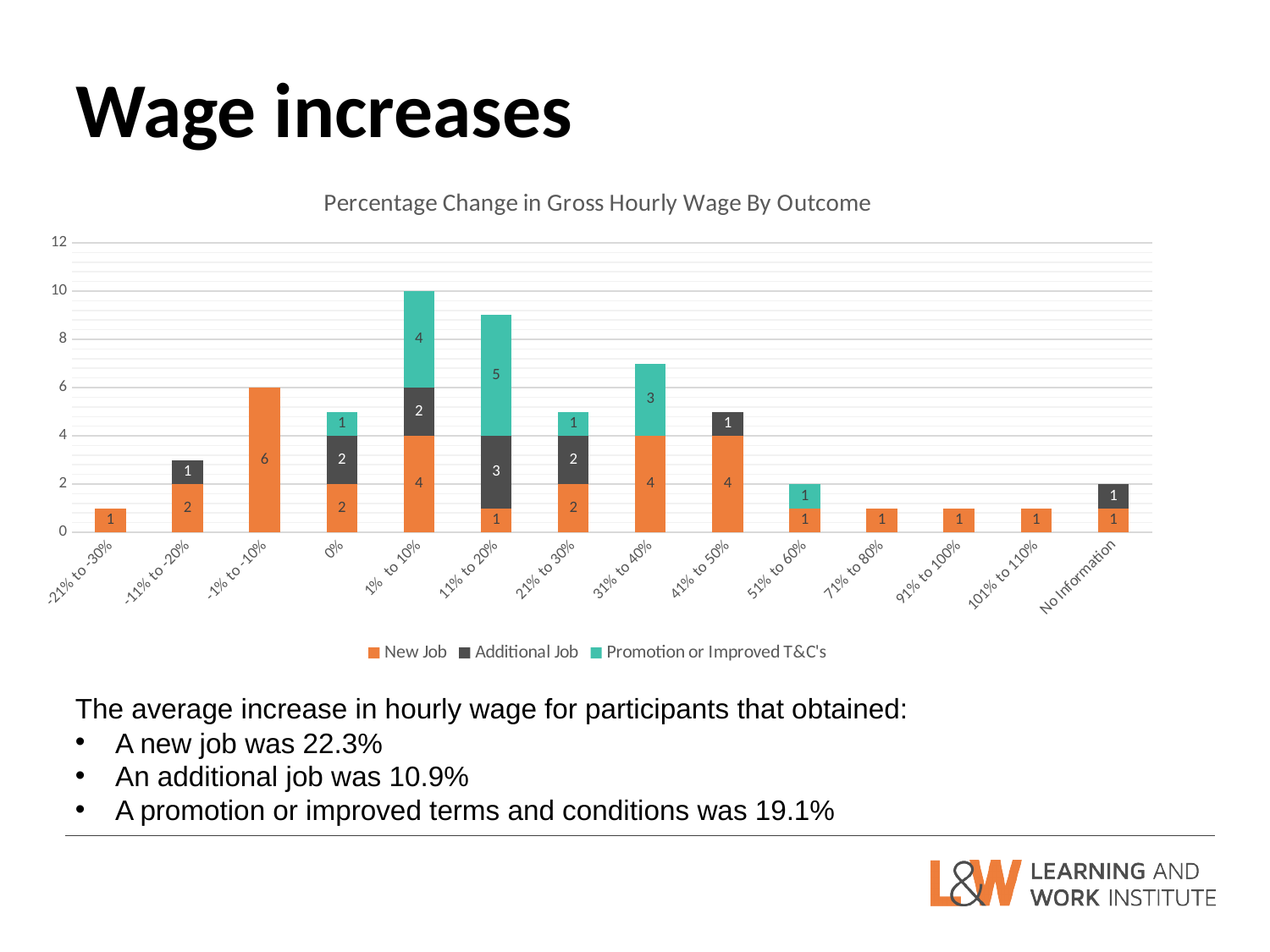
What is the total of the stacked bar for the 1% to 10% category? 10 Which is larger, the New Job value for -1% to -10% or the New Job value for 41% to 50%? -1% to -10% What is the New Job value for the -1% to -10% category? 6 What type of chart is shown on the slide? Stacked bar chart What is the Additional Job value for the 11% to 20% category? 3 What is the difference between the Promotion or Improved T&C's values for 11% to 20% and 1% to 10%? 1 Which category has the highest stacked bar total? 1% to 10% What is the total of the stacked bar for the 31% to 40% category? 7 How many categories are shown on the x axis? 14 What is the Promotion or Improved T&C's value for the 11% to 20% category? 5 How many series does the legend list? 3 What is the title of the chart? Percentage Change in Gross Hourly Wage By Outcome